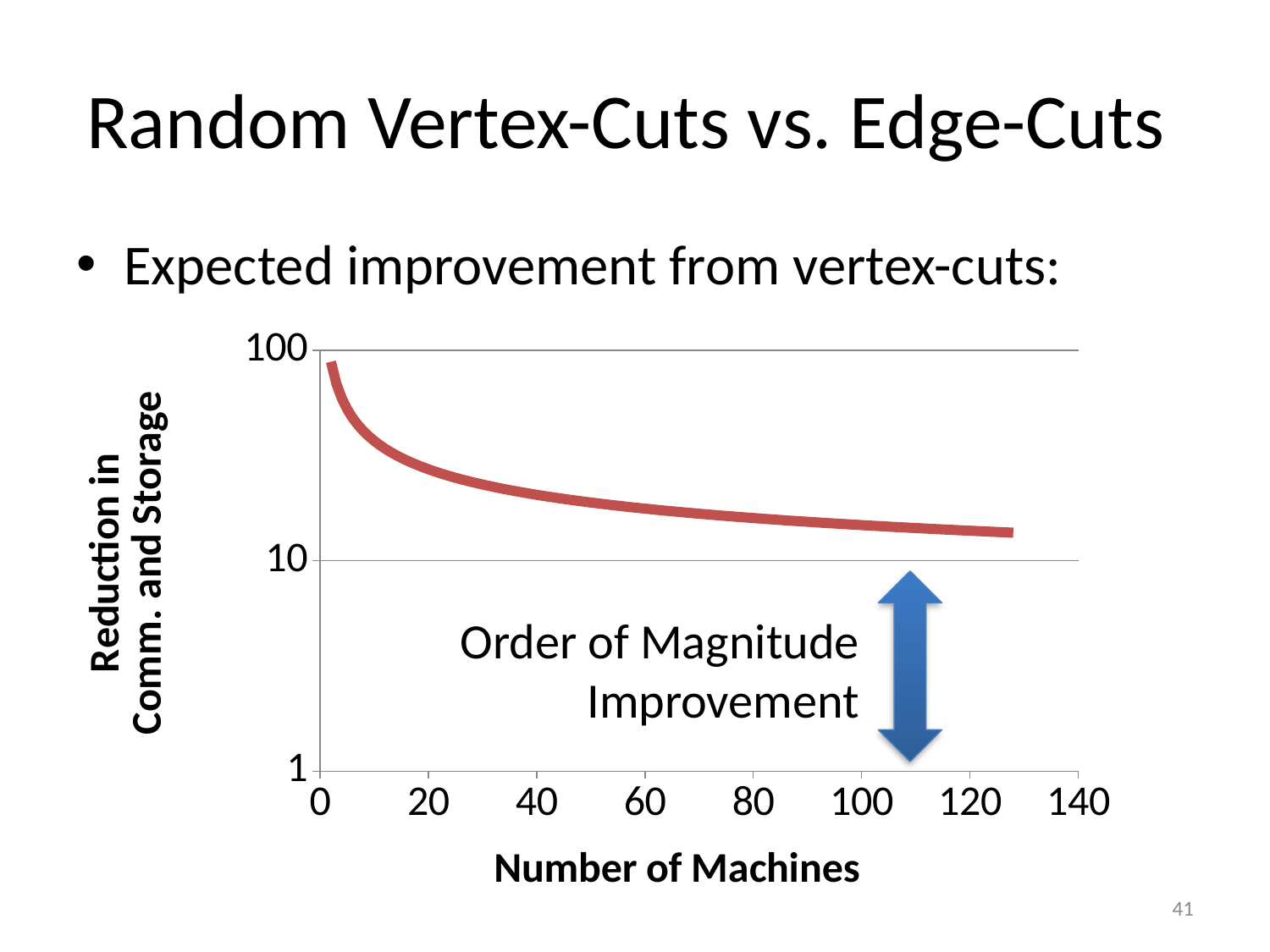
Is the value for 120 machines greater or less than 10? greater What kind of chart is shown on the slide? line chart What is the title of the y axis? Reduction in Comm. and Storage Does the reduction in comm. and storage rise or fall as the number of machines increases? fall What is the title of the x axis? Number of Machines Is the value for 20 machines greater or less than 10? greater Is the value for 40 machines greater or less than 100? less How many tick labels are shown on the x axis? 8 What is the highest tick label shown on the y axis? 100